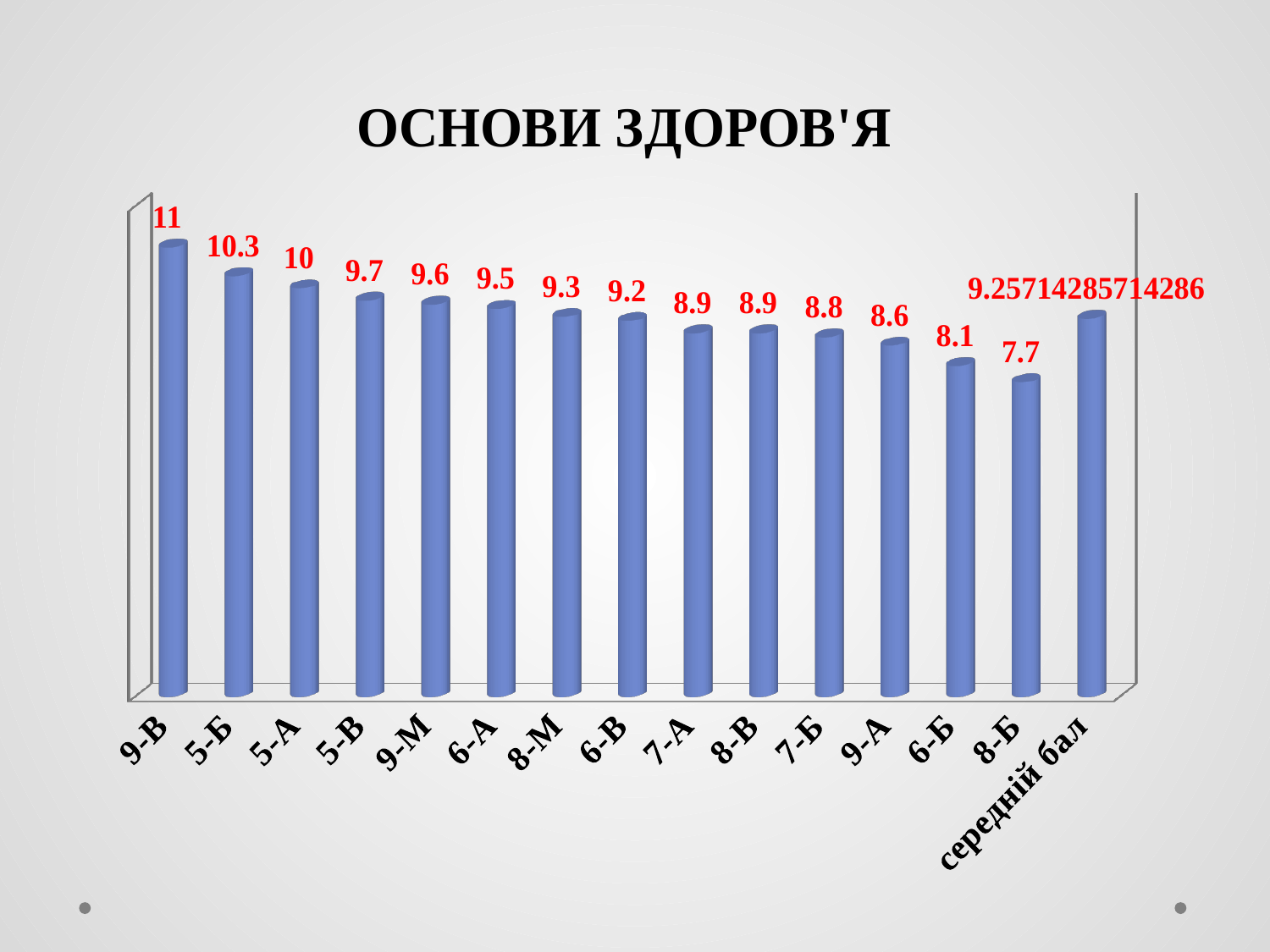
Which category has the lowest value? 8-Б Which category has the highest value? 9-В What is the value for 8-Б? 7.7 What is the difference between the values for 9-В and 8-Б? 3.3 Which is larger, the value for 5-А or the value for 9-А? 5-А How many categories are shown on the x axis? 15 What is the value for 9-В? 11 What is the value for 5-Б? 10.3 What is the title of the chart? ОСНОВИ ЗДОРОВ'Я What kind of chart is shown on the slide? bar chart What is the value shown for середній бал? 9.25714285714286 What is the difference between the values for 5-Б and 6-Б? 2.2